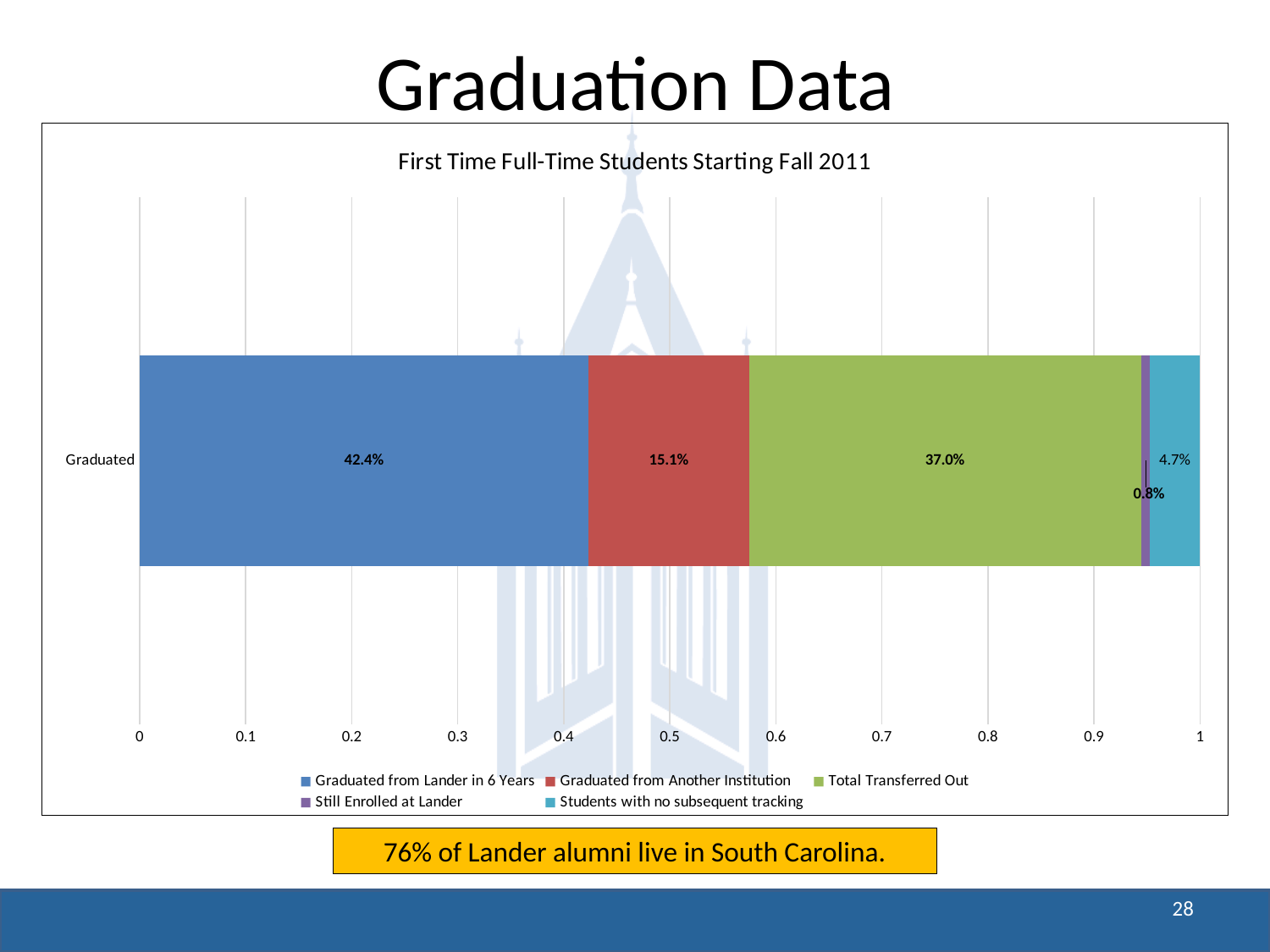
What percentage of students graduated from Lander in 6 years? 42.4% What is the difference between Graduated from Lander in 6 Years and Total Transferred Out? 5.4% Which series has the smallest value in the bar? Still Enrolled at Lander What is the value for Graduated from Another Institution? 15.1% Which is larger: Graduated from Another Institution or Students with no subsequent tracking? Graduated from Another Institution What kind of chart is shown on the slide? Stacked bar chart What is the value for Still Enrolled at Lander? 0.8% What is the value for Students with no subsequent tracking? 4.7% How many series does the legend list? 5 What is the title of the chart? First Time Full-Time Students Starting Fall 2011 What is the value for Total Transferred Out? 37.0% Which series has the largest value in the bar? Graduated from Lander in 6 Years